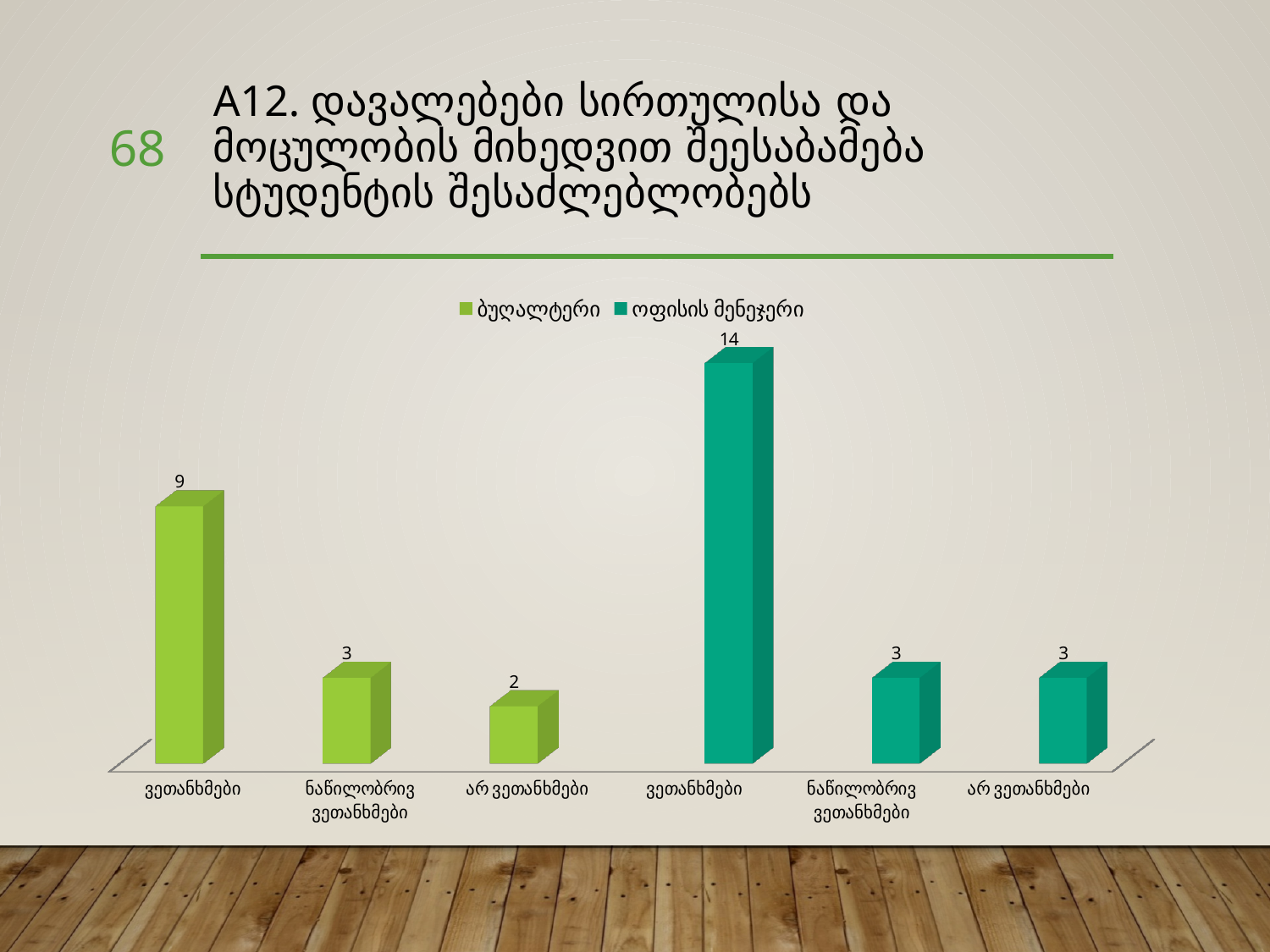
Which bar has the highest value on the chart? ვეთანხმები (ოფისის მენეჯერი) How many bars are plotted on the chart? 6 How many series does the legend list? 2 What is the value for არ ვეთანხმები in the ბუღალტერი series? 2 What is the value for ვეთანხმები in the ბუღალტერი series? 9 What is the value for ვეთანხმები in the ოფისის მენეჯერი series? 14 Which is larger: the ვეთანხმები value for ბუღალტერი or for ოფისის მენეჯერი? ოფისის მენეჯერი What kind of chart is shown on the slide? Bar chart What is the value for ნაწილობრივ ვეთანხმები in the ოფისის მენეჯერი series? 3 Which bar has the lowest value on the chart? არ ვეთანხმები (ბუღალტერი) Which series is shown in teal in the legend? ოფისის მენეჯერი What is the difference between the ვეთანხმები values for ოფისის მენეჯერი and ბუღალტერი? 5